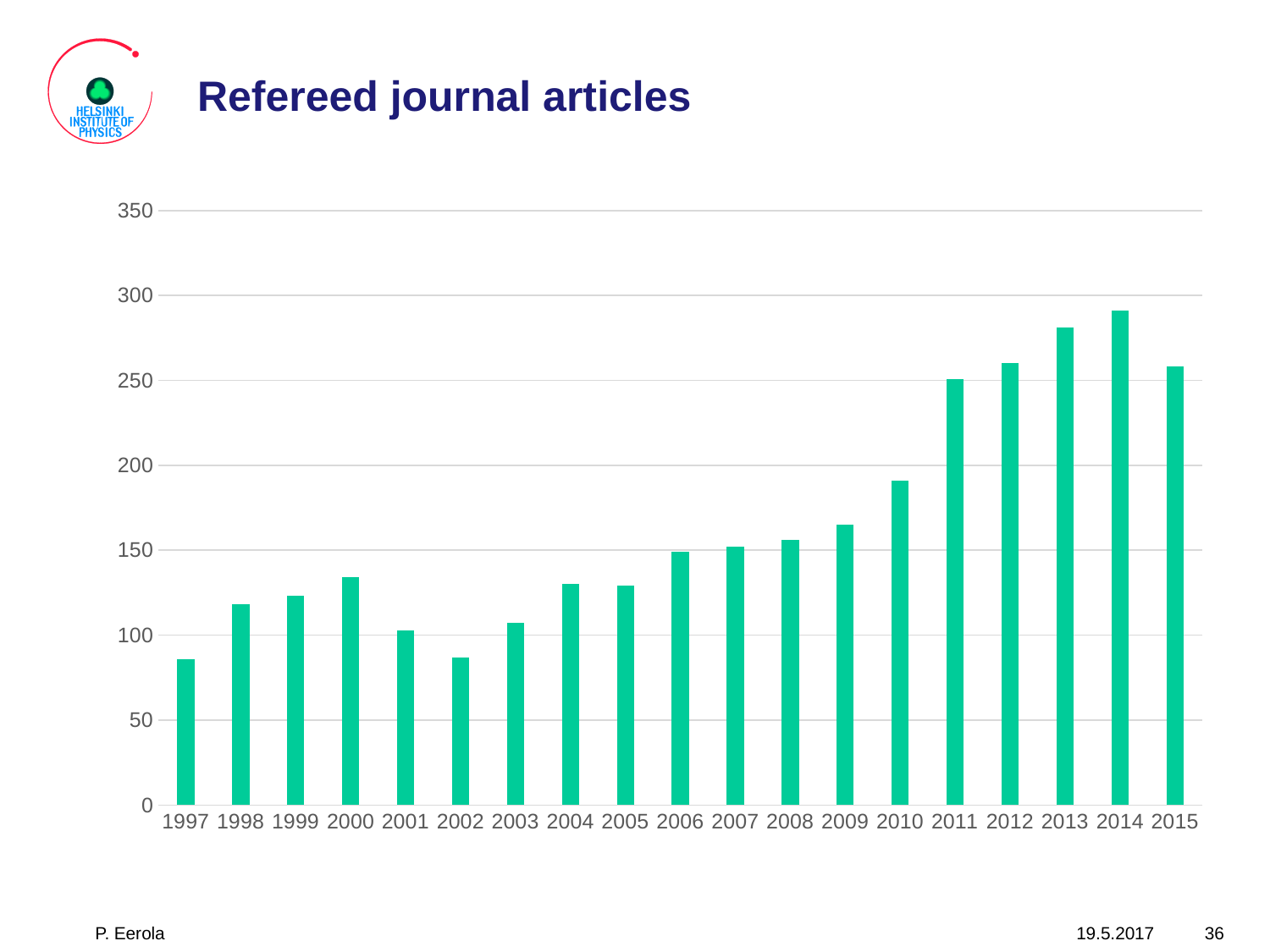
Is the value for 2002 greater or less than 100? less Is the value for 2011 greater or less than 200? greater Do the values generally rise or fall from 2002 to 2014? rise Is the value for 2014 greater or less than 250? greater Which year has the larger value, 2000 or 2001? 2000 What is the title of the chart on the slide? Refereed journal articles What kind of chart is shown on the slide? bar chart How many years are shown on the x axis of the chart? 19 Which year has the larger value, 2013 or 2015? 2013 Which year has the highest number of refereed journal articles? 2014